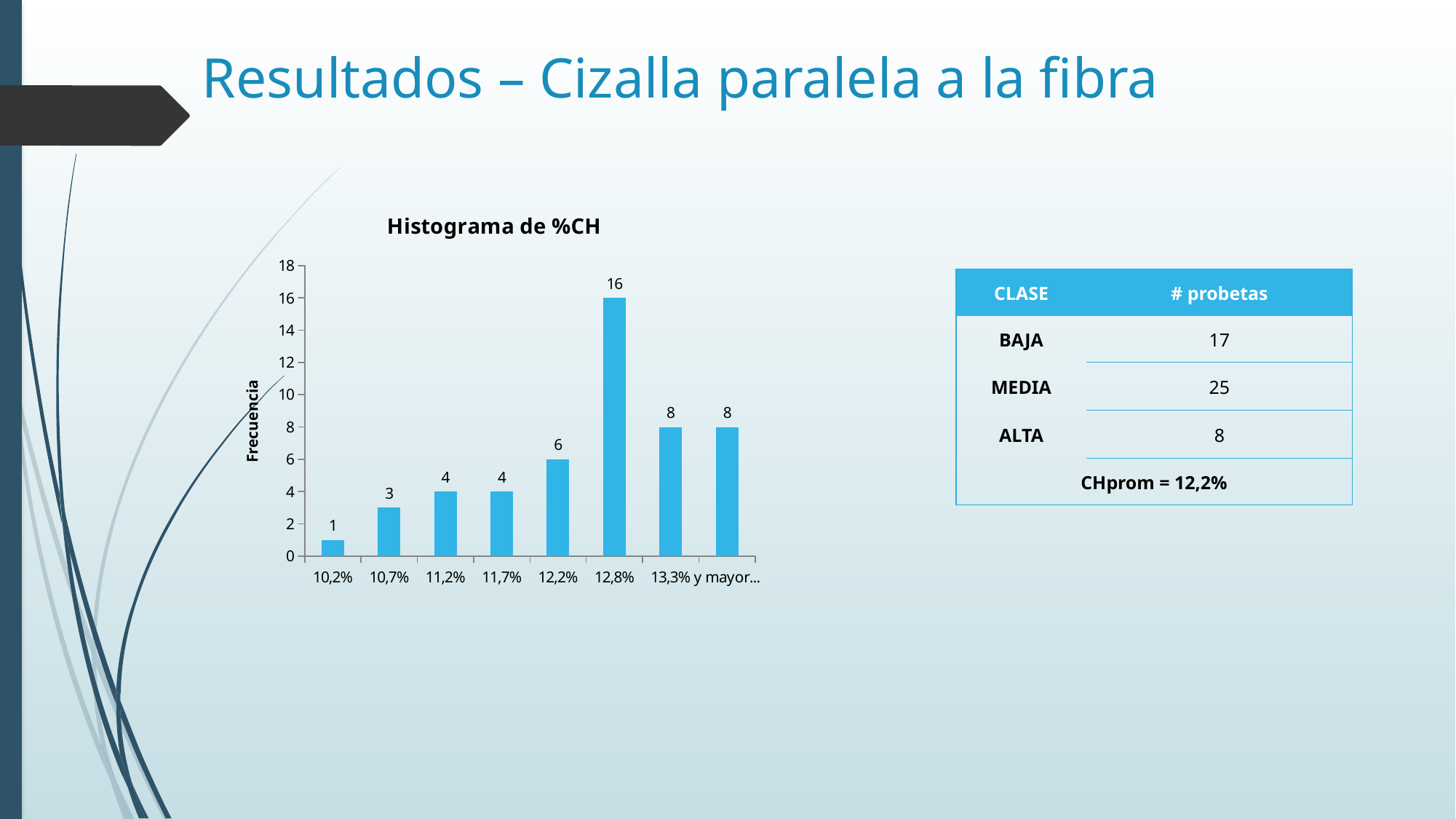
What is the frequency for the 12,8% category? 16 What is the frequency for the 10,7% category? 3 What is the label of the vertical axis? Frecuencia How many bars are plotted in the chart? 8 What is the title of the chart? Histograma de %CH Which has a higher frequency, 11,2% or 12,2%? 12,2% What type of chart is shown on the slide? bar chart Which category has the highest frequency? 12,8% What is the frequency for the 10,2% category? 1 What is the frequency for the 12,2% category? 6 What is the difference between the frequency for 12,8% and the frequency for 13,3%? 8 Which category has the lowest frequency? 10,2%